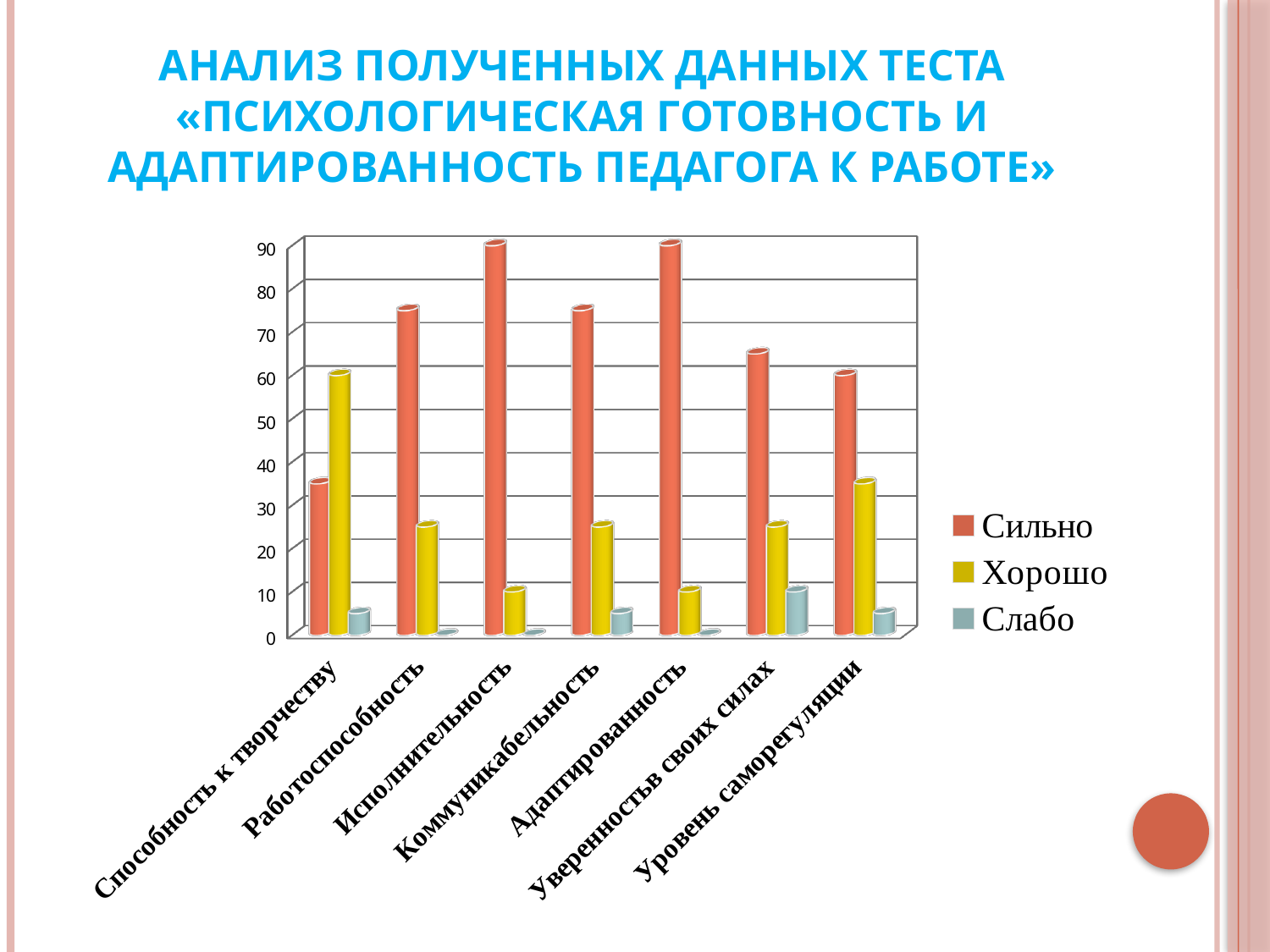
For Способность к творчеству, which is larger: the Сильно value or the Хорошо value? Хорошо Which category has the highest value for the Хорошо series? Способность к творчеству How many categories are shown along the x axis of the chart? 7 What kind of chart is shown on the slide? bar chart Is the Сильно value for Работоспособность greater or less than 70? greater Which series is shown in yellow in the chart? Хорошо Which category has the lowest value for the Сильно series? Способность к творчеству How many series does the chart legend list? 3 Is the Сильно value for Коммуникабельность greater or less than 80? less Which series are listed in the chart legend? Сильно, Хорошо, Слабо Is the Сильно value for Уверенность в своих силах greater or less than 70? less